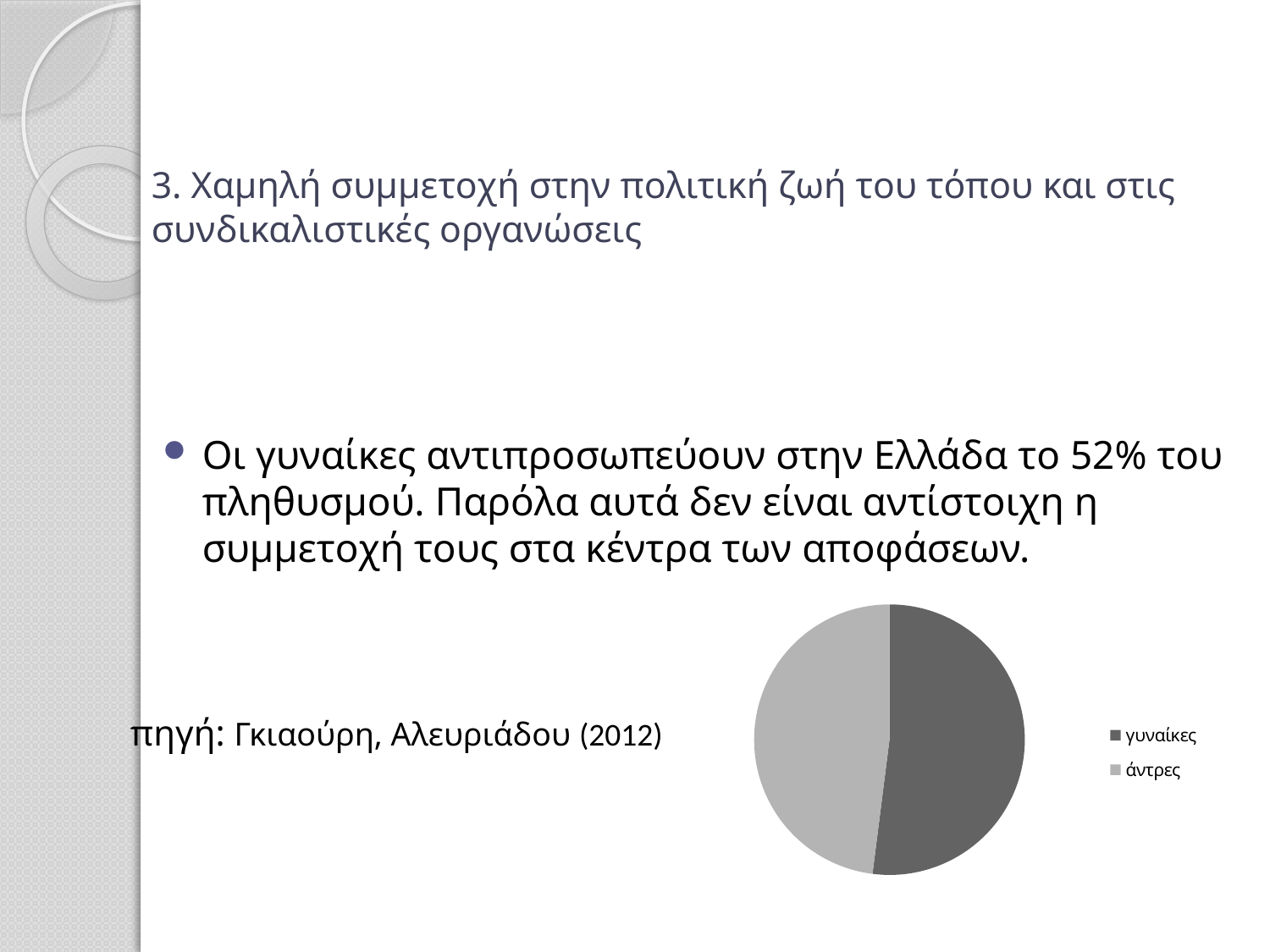
Which slice of the pie chart is larger, γυναίκες or άντρες? γυναίκες Which category has the smallest slice in the pie chart? άντρες According to the slide, what share of the population in Greece do women (γυναίκες) represent? 52% How many entries does the legend of the pie chart list? 2 What are the two categories listed in the legend of the pie chart? γυναίκες, άντρες How many slices does the pie chart have? 2 What kind of chart is shown on the slide? pie chart Which legend entry is shown in the darker grey colour in the pie chart? γυναίκες Which category has the largest slice in the pie chart? γυναίκες